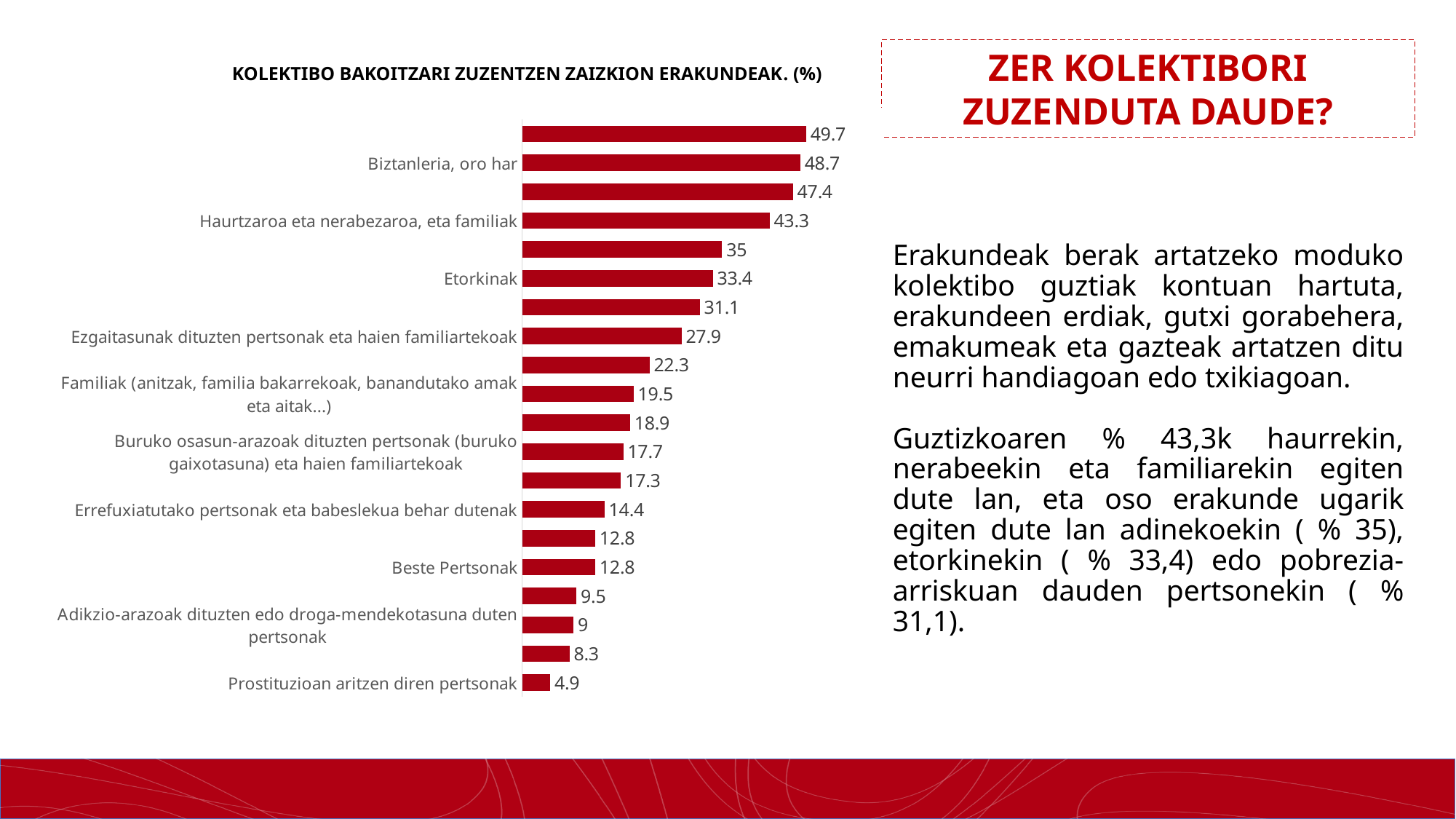
What is the value for "Haurtzaroa eta nerabezaroa, eta familiak"? 43.3 Which labelled category has the lowest value? Prostituzioan aritzen diren pertsonak What kind of chart is shown on the slide? Bar chart What is the highest value shown on the chart? 49.7 What is the difference between the values for "Haurtzaroa eta nerabezaroa, eta familiak" and "Etorkinak"? 9.9 What is the value for "Adikzio-arazoak dituzten edo droga-mendekotasuna duten pertsonak"? 9 Which is larger: the value for "Ezgaitasunak dituzten pertsonak eta haien familiartekoak" or for "Familiak (anitzak, familia bakarrekoak, banandutako amak eta aitak...)"? Ezgaitasunak dituzten pertsonak eta haien familiartekoak What is the value for "Errefuxiatutako pertsonak eta babeslekua behar dutenak"? 14.4 What is the value for "Biztanleria, oro har"? 48.7 What is the title of the chart? KOLEKTIBO BAKOITZARI ZUZENTZEN ZAIZKION ERAKUNDEAK. (%) How many bars are plotted on the chart? 20 What is the value for "Etorkinak"? 33.4